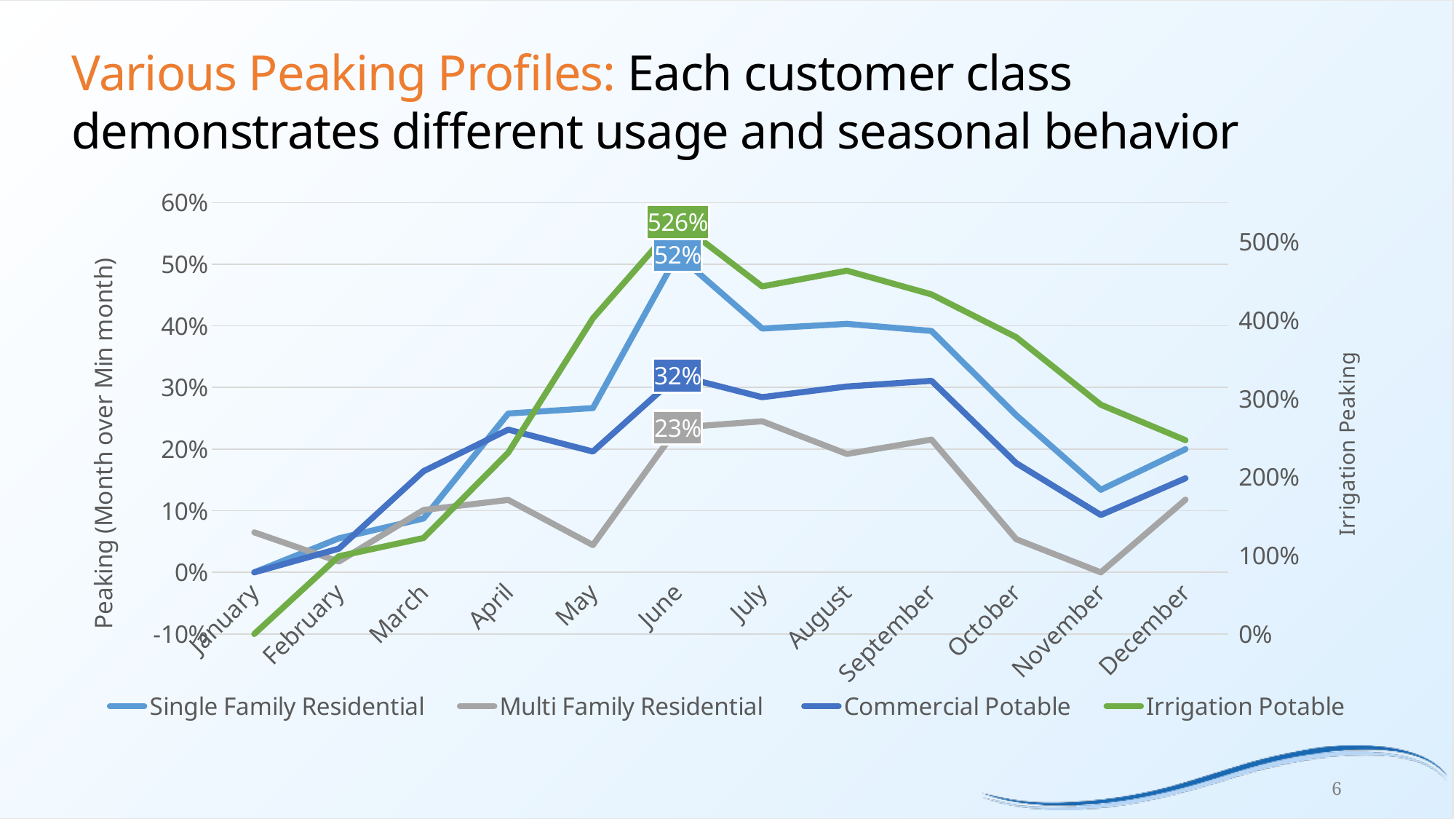
What is the difference between the June values for Single Family Residential and Commercial Potable? 20% What is the data label shown for Irrigation Potable in June? 526% What is the data label shown for Single Family Residential in June? 52% How many series does the legend list? 4 Is the Single Family Residential value for November greater or less than 20%? less How many months are shown on the x axis? 12 What is the data label shown for Multi Family Residential in June? 23% In which month does the Single Family Residential line reach its highest value? June In June, which is larger: the Single Family Residential value or the Multi Family Residential value? Single Family Residential What is the data label shown for Commercial Potable in June? 32% What kind of chart is shown on the slide? line chart Does the Single Family Residential line rise or fall from June to November? fall